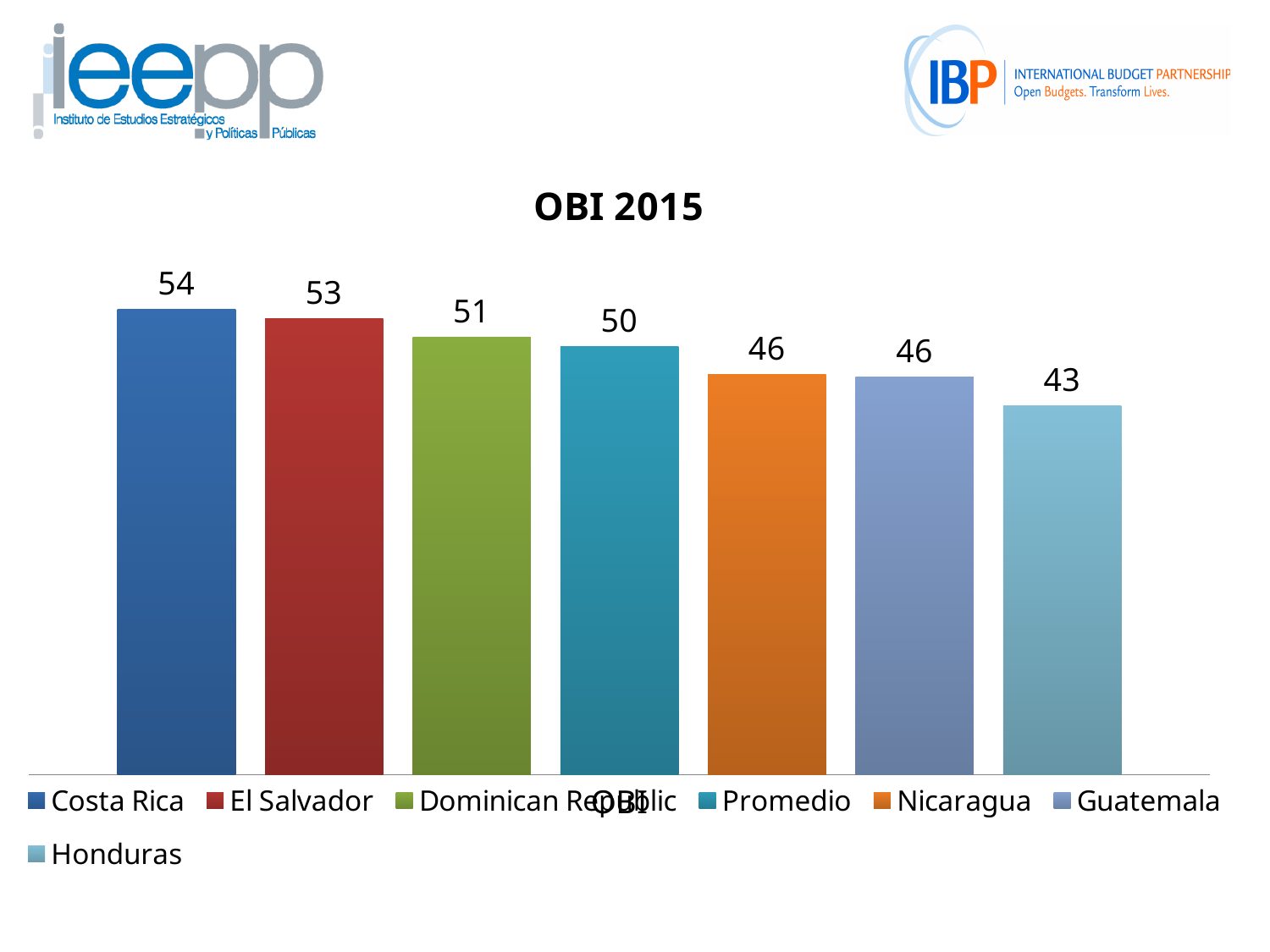
How many series does the legend list? 7 What is the OBI 2015 value for Costa Rica? 54 What kind of chart is shown on the slide? Bar chart Which is larger, the value for El Salvador or the value for Guatemala? El Salvador What is the OBI 2015 value for Honduras? 43 What is the OBI 2015 value for Promedio? 50 Which series has the highest value in the OBI 2015 chart? Costa Rica What is the difference between the values for El Salvador and Nicaragua? 7 What is the OBI 2015 value for Dominican Republic? 51 What is the title of the chart? OBI 2015 What is the difference between the values for Costa Rica and Honduras? 11 Which series has the lowest value in the OBI 2015 chart? Honduras